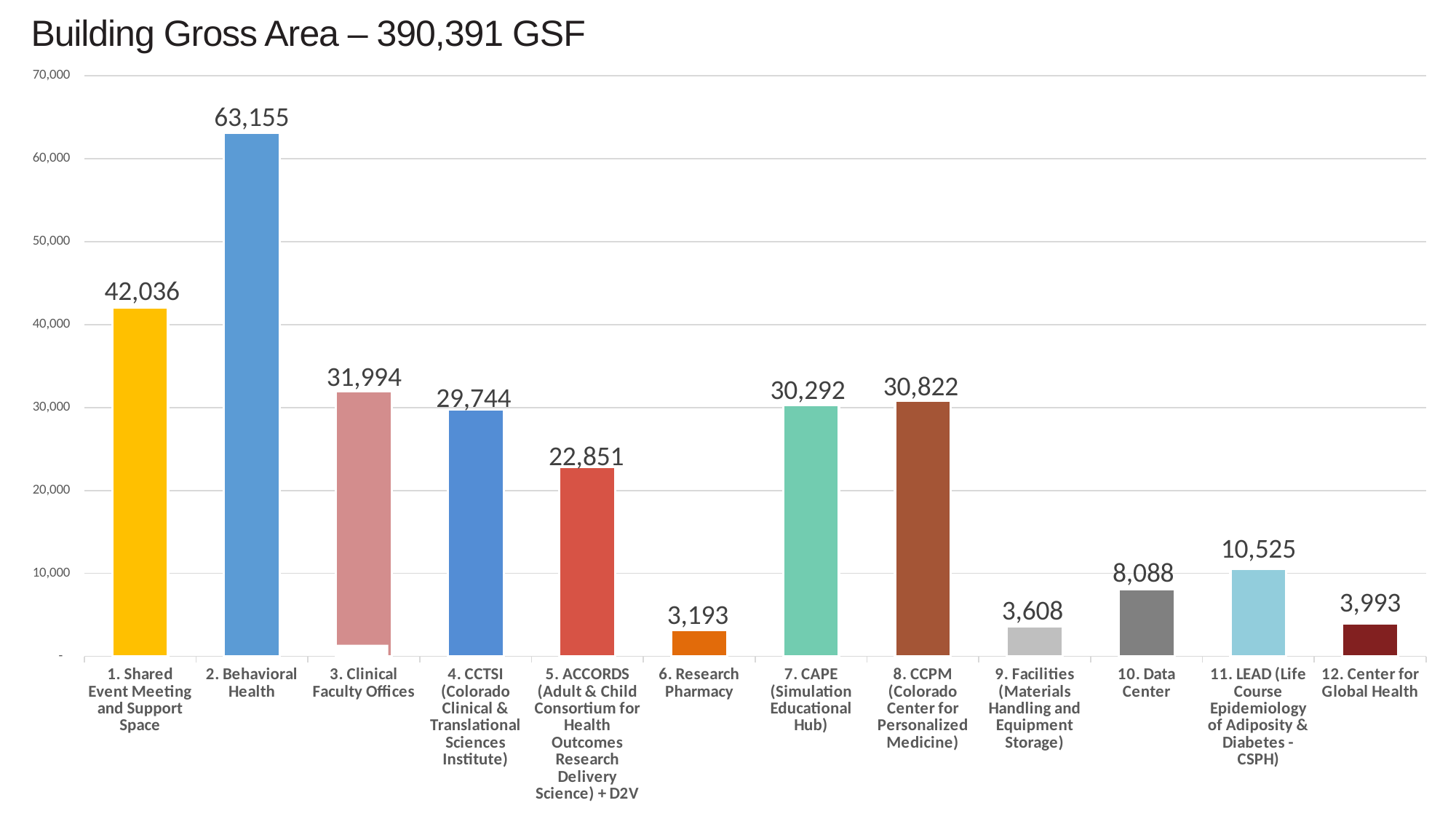
Which category has the highest value? 2. Behavioral Health What kind of chart is shown on the slide? bar chart What is the value for 2. Behavioral Health? 63,155 Is the value for 3. Clinical Faculty Offices greater or less than 30,000? greater Which category has the lowest value? 6. Research Pharmacy What is the title of the chart? Building Gross Area – 390,391 GSF How many categories are shown in the chart? 12 Which is larger, the value for 3. Clinical Faculty Offices or the value for 4. CCTSI (Colorado Clinical & Translational Sciences Institute)? 3. Clinical Faculty Offices What is the difference between the values for 11. LEAD (Life Course Epidemiology of Adiposity & Diabetes - CSPH) and 10. Data Center? 2,437 What is the value for 5. ACCORDS (Adult & Child Consortium for Health Outcomes Research Delivery Science) + D2V? 22,851 What is the value for 10. Data Center? 8,088 What is the difference between the values for 2. Behavioral Health and 1. Shared Event Meeting and Support Space? 21,119